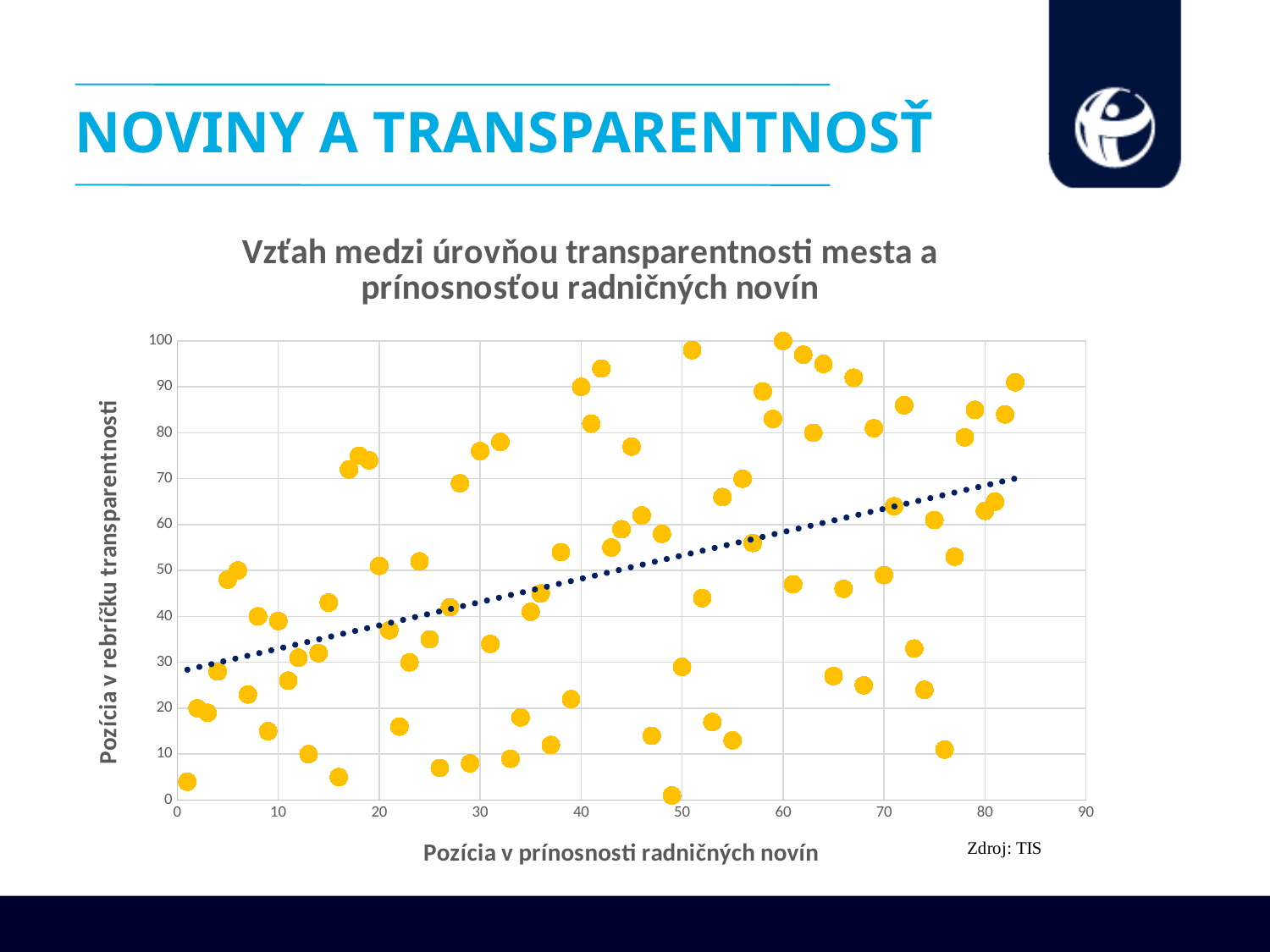
Is the lowest plotted point on the vertical axis greater or less than 10? less What kind of chart is shown on the slide? Scatter chart What is the title of the chart? Vzťah medzi úrovňou transparentnosti mesta a prínosnosťou radničných novín Does the dotted trend line rise or fall as the x-axis value increases? Rises Is the value of the dotted trend line at the left edge of the chart (x = 0) greater or less than 20? greater Is the highest plotted point on the vertical axis greater or less than 90? greater What is the label of the horizontal axis of the chart? Pozícia v prínosnosti radničných novín